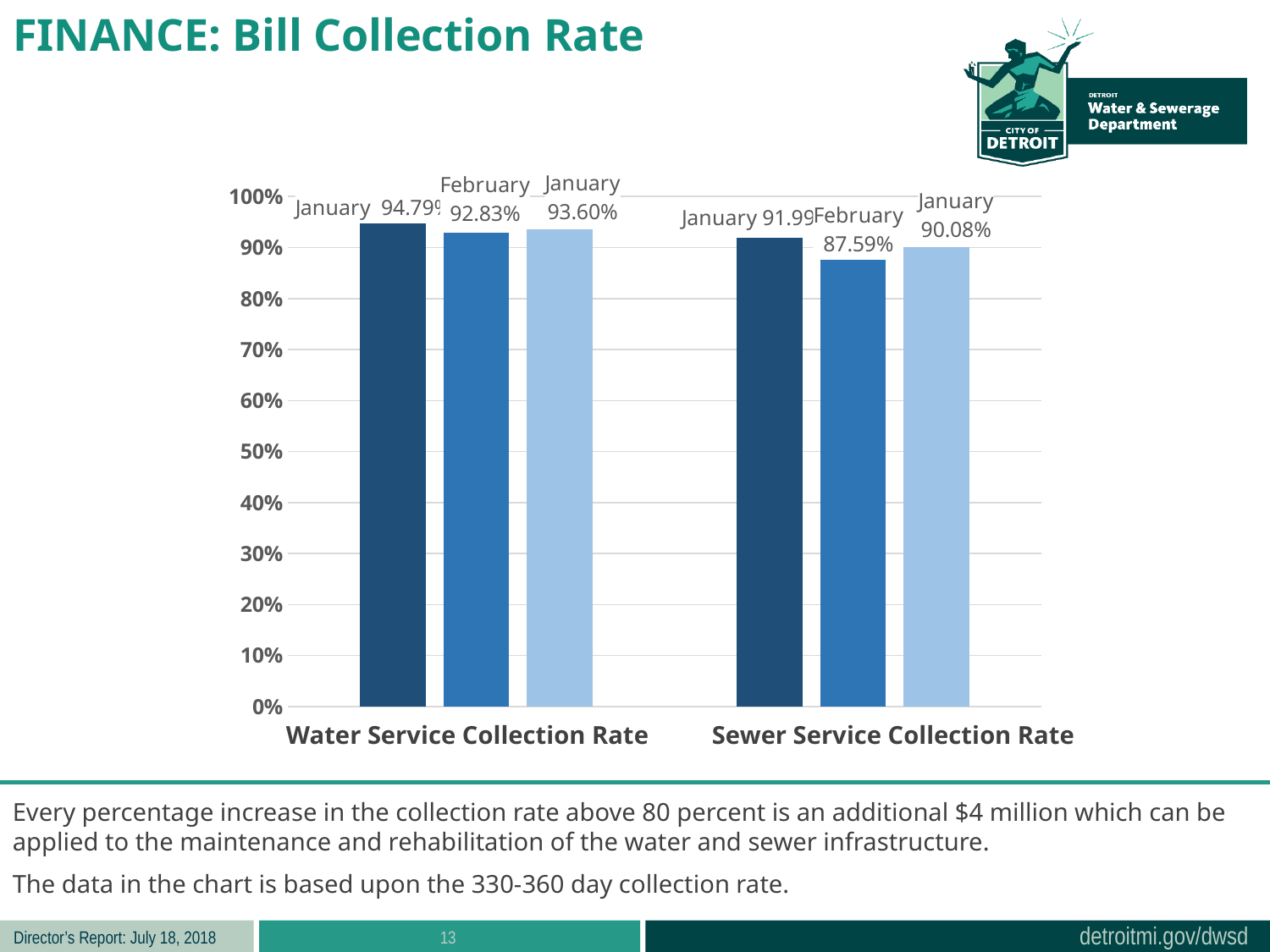
What is the February value for Water Service Collection Rate? 92.83% What is the title of the slide containing the chart? FINANCE: Bill Collection Rate Which is larger: the February value for Water Service Collection Rate or the February value for Sewer Service Collection Rate? Water Service Collection Rate What kind of chart is shown on the slide? Bar chart What is the difference between the February values for Water Service Collection Rate (92.83%) and Sewer Service Collection Rate (87.59%)? 5.24% How many category groups are shown on the x axis? 2 What value is shown on the light blue (third) bar for Water Service Collection Rate? 93.60% What is the February value for Sewer Service Collection Rate? 87.59% Is the February value for Sewer Service Collection Rate greater or less than 90%? less What value is shown on the light blue (third) bar for Sewer Service Collection Rate? 90.08% Which category group has the lowest bar on the chart? Sewer Service Collection Rate How many bars are plotted in each category group? 3